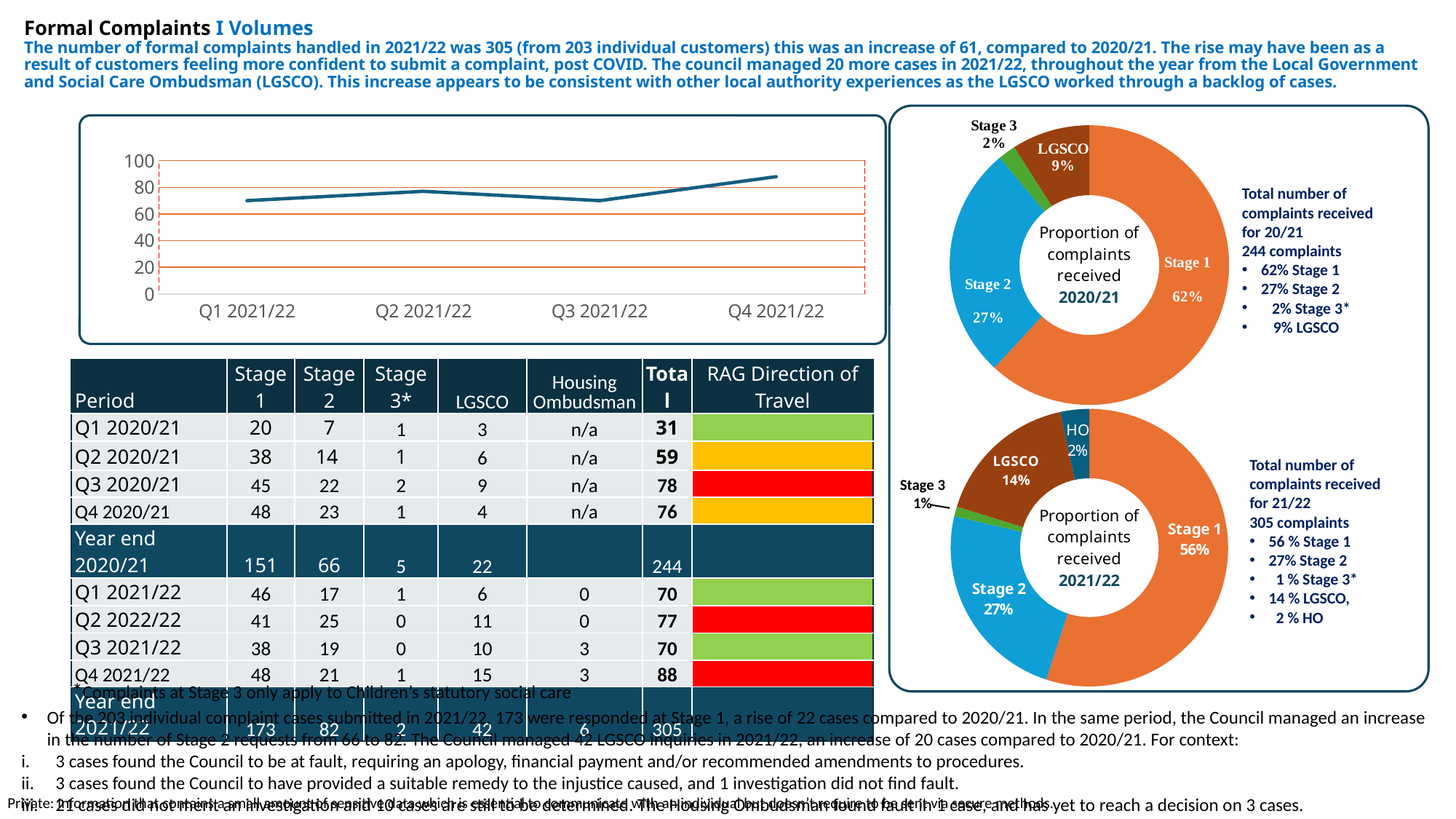
In the 'Proportion of complaints received 2021/22' donut chart, what percentage is Stage 1? 56% In the line chart in the top-left panel, is the value for Q3 2021/22 greater or less than 80? less In the line chart in the top-left panel, how many quarters are plotted along the x axis? 4 By how many percentage points does the Stage 1 share in the 2020/21 donut chart exceed the Stage 1 share in the 2021/22 donut chart? 6 In the line chart in the top-left panel, is the value for Q4 2021/22 greater or less than 80? greater What kind of chart is the chart in the top-left panel showing Q1 2021/22 to Q4 2021/22? Line chart In the 'Proportion of complaints received 2021/22' donut chart, how many categories are shown? 5 In the 'Proportion of complaints received 2021/22' donut chart, which is larger, LGSCO or HO? LGSCO In the 'Proportion of complaints received 2020/21' donut chart, which category has the smallest share? Stage 3 In the 'Proportion of complaints received 2020/21' donut chart, what percentage is LGSCO? 9% In the 'Proportion of complaints received 2020/21' donut chart, what percentage is Stage 1? 62% In the line chart in the top-left panel, which quarter has the highest value? Q4 2021/22